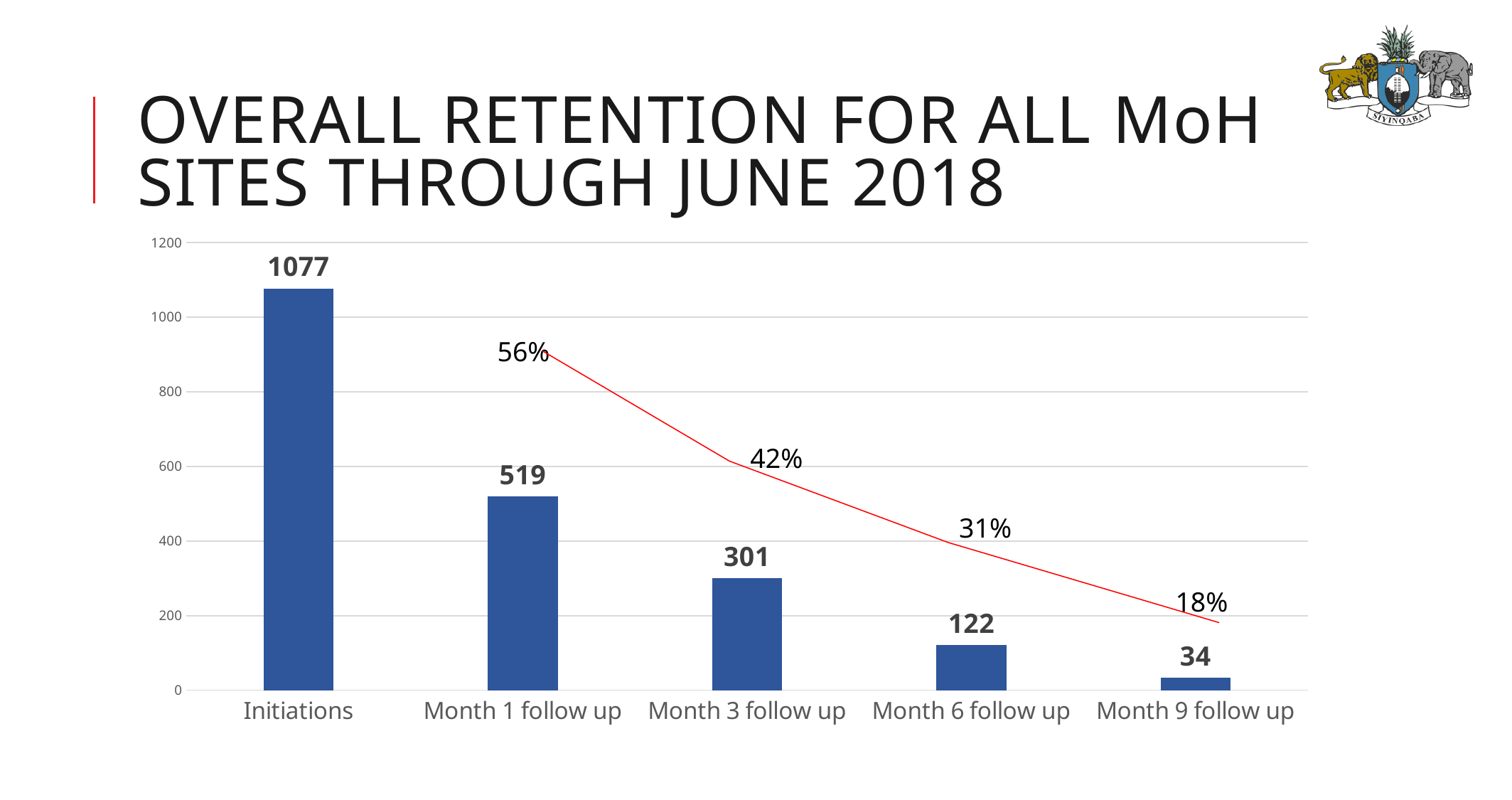
What percentage is shown on the red line at Month 6 follow up? 31% What is the difference between the bar values for Initiations and Month 1 follow up? 558 Which category has the lowest bar? Month 9 follow up How many categories are shown on the x axis? 5 Do the bar values rise or fall from Initiations to Month 9 follow up? fall What percentage is shown on the red line at Month 1 follow up? 56% What is the value of the bar for Initiations? 1077 Which is larger, the bar for Month 3 follow up or the bar for Month 6 follow up? Month 3 follow up What is the value of the bar for Month 9 follow up? 34 Which category has the highest bar? Initiations What is the value of the bar for Month 3 follow up? 301 What is the title of the slide? OVERALL RETENTION FOR ALL MoH SITES THROUGH JUNE 2018